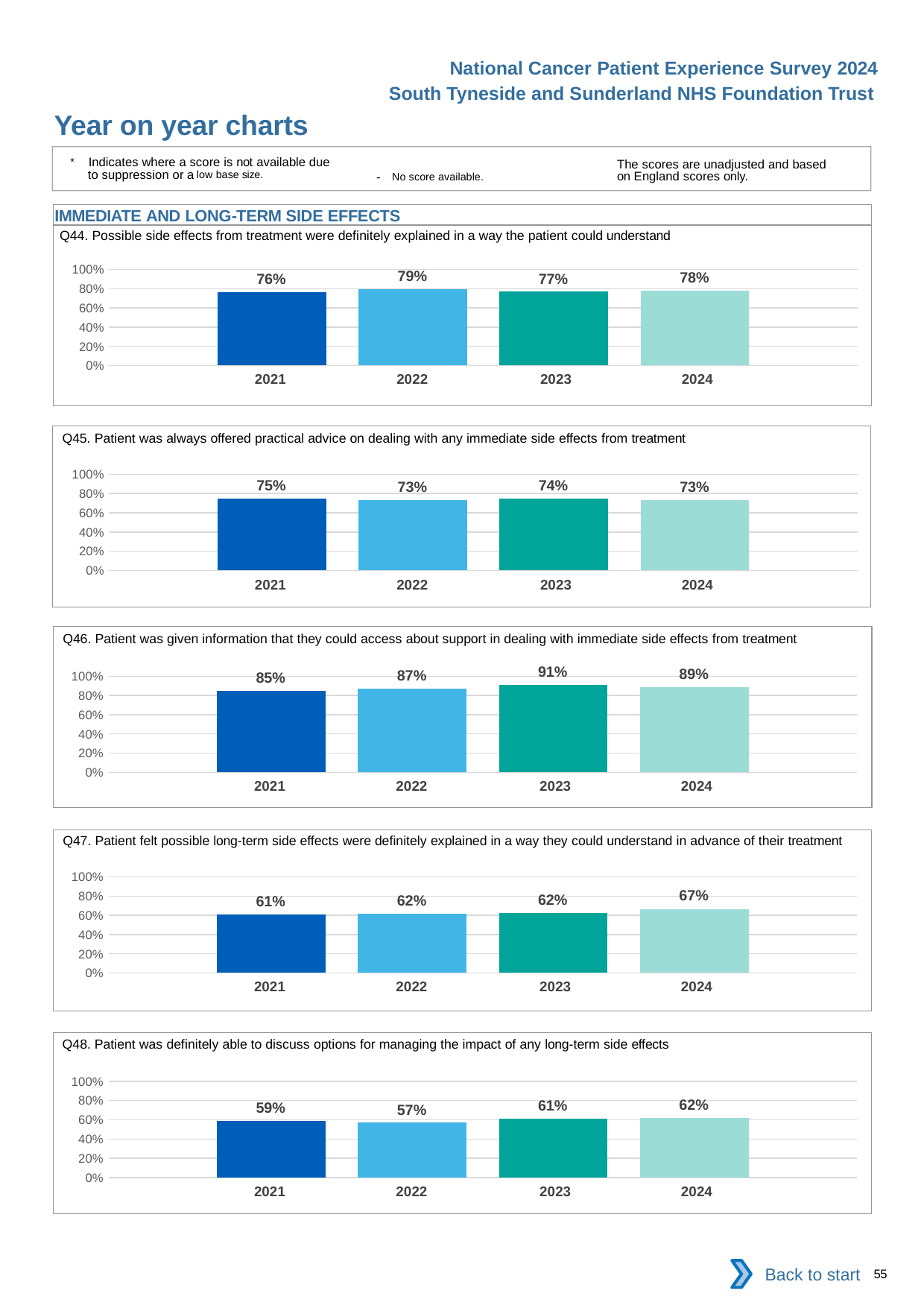
In the Q47 chart, which year has the highest value? 2024 In the Q46 chart, is the value for 2023 larger than the value for 2024? Yes How many years are shown in the Q44 chart? 4 In the Q48 chart, which year has the lowest value? 2022 In the Q45 chart, which year has the highest value? 2021 In the Q46 chart, what is the difference between the 2023 and 2021 values? 6% What kind of chart is the Q45 chart? Bar chart In the Q47 chart, what is the difference between the 2024 and 2023 values? 5% In the Q47 chart, is the value for 2021 greater or less than 80%? less How many charts are shown on the slide? 5 In the Q44 chart, what is the value for 2022? 79% In the Q48 chart, what is the value for 2024? 62%